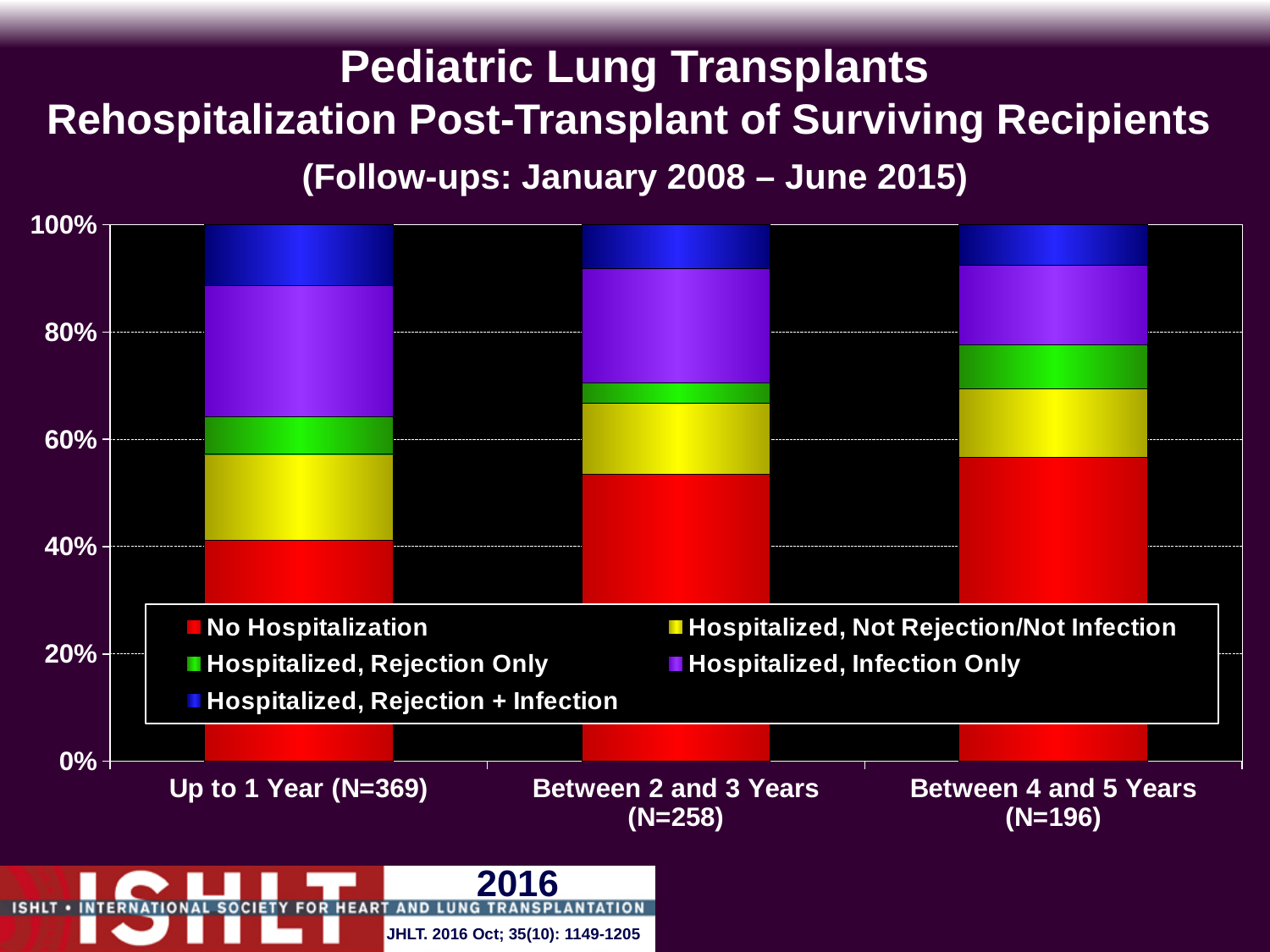
What kind of chart is shown on the slide? Stacked bar chart How many series does the legend list? 5 Which follow-up category has the smallest No Hospitalization share? Up to 1 Year (N=369) Is the No Hospitalization share for Between 2 and 3 Years greater or less than 60%? less Does the No Hospitalization share rise or fall from Up to 1 Year to Between 4 and 5 Years? rise Which colour represents No Hospitalization in the legend? Red What is the N for the Up to 1 Year category? 369 Is the No Hospitalization share for Between 4 and 5 Years greater or less than 40%? greater Which is larger, the Hospitalized, Infection Only share for Up to 1 Year or for Between 4 and 5 Years? Up to 1 Year How many follow-up categories are shown on the x axis? 3 Which is larger, the Hospitalized, Rejection Only share for Between 2 and 3 Years or for Between 4 and 5 Years? Between 4 and 5 Years Is the No Hospitalization share for Up to 1 Year greater or less than 60%? less